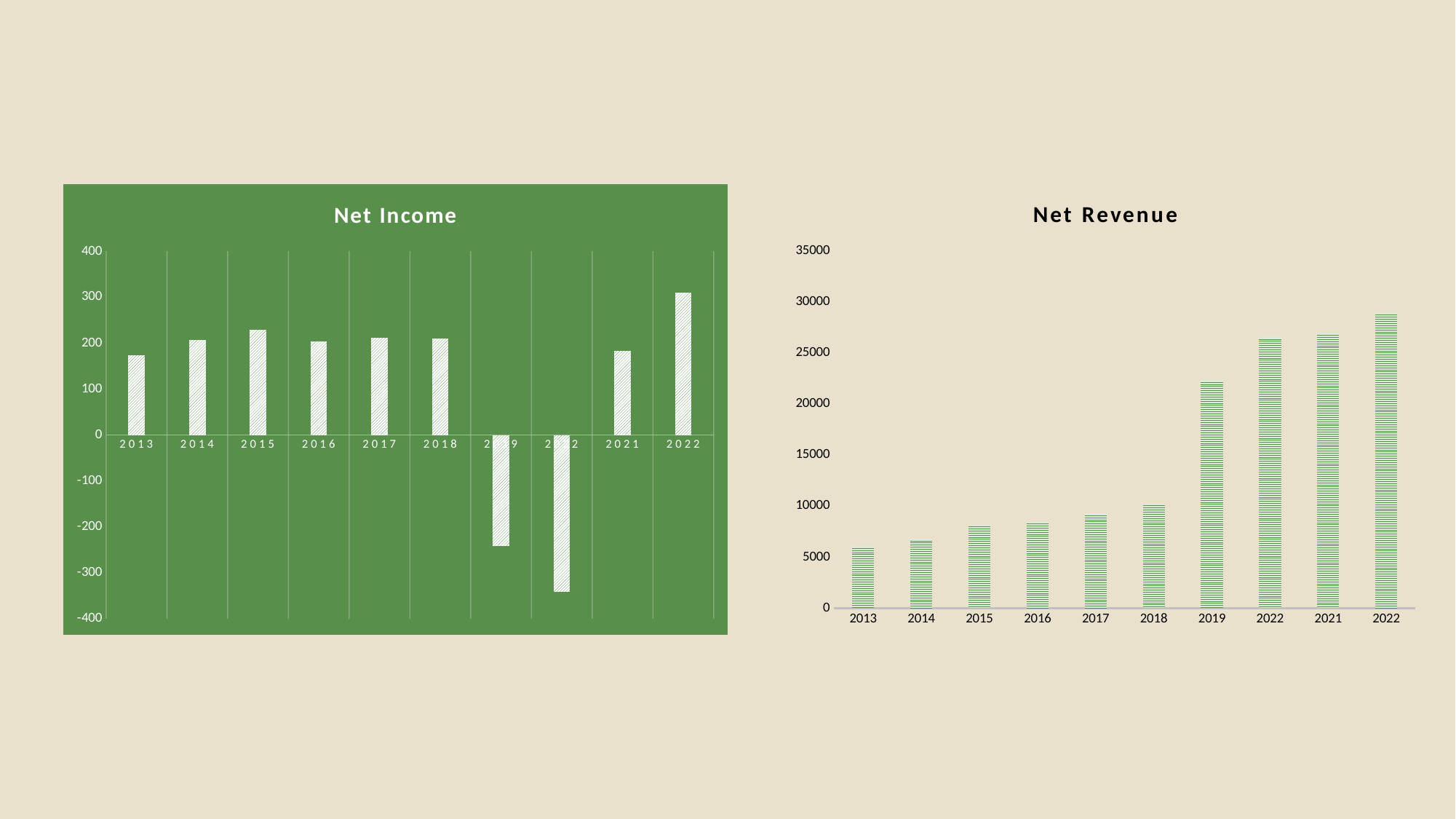
In the Net Income chart, which is larger, the value for 2013 or the value for 2015? 2015 In the Net Income chart, is the value for 2015 greater or less than 200? greater What kind of chart is the Net Revenue chart? bar chart What kind of chart is the Net Income chart? bar chart In the Net Income chart, is the value for 2019 greater or less than -200? less In the Net Revenue chart, do the values generally rise or fall from 2013 to the last bar? rise How many bars in the Net Income chart are negative (below zero)? 2 In the Net Revenue chart, which is larger, the value for 2019 or the value for 2021? 2021 In the Net Revenue chart, is the value for 2013 greater or less than 5000? greater How many bars does the Net Revenue chart show? 10 In the Net Revenue chart, which year has the lowest value? 2013